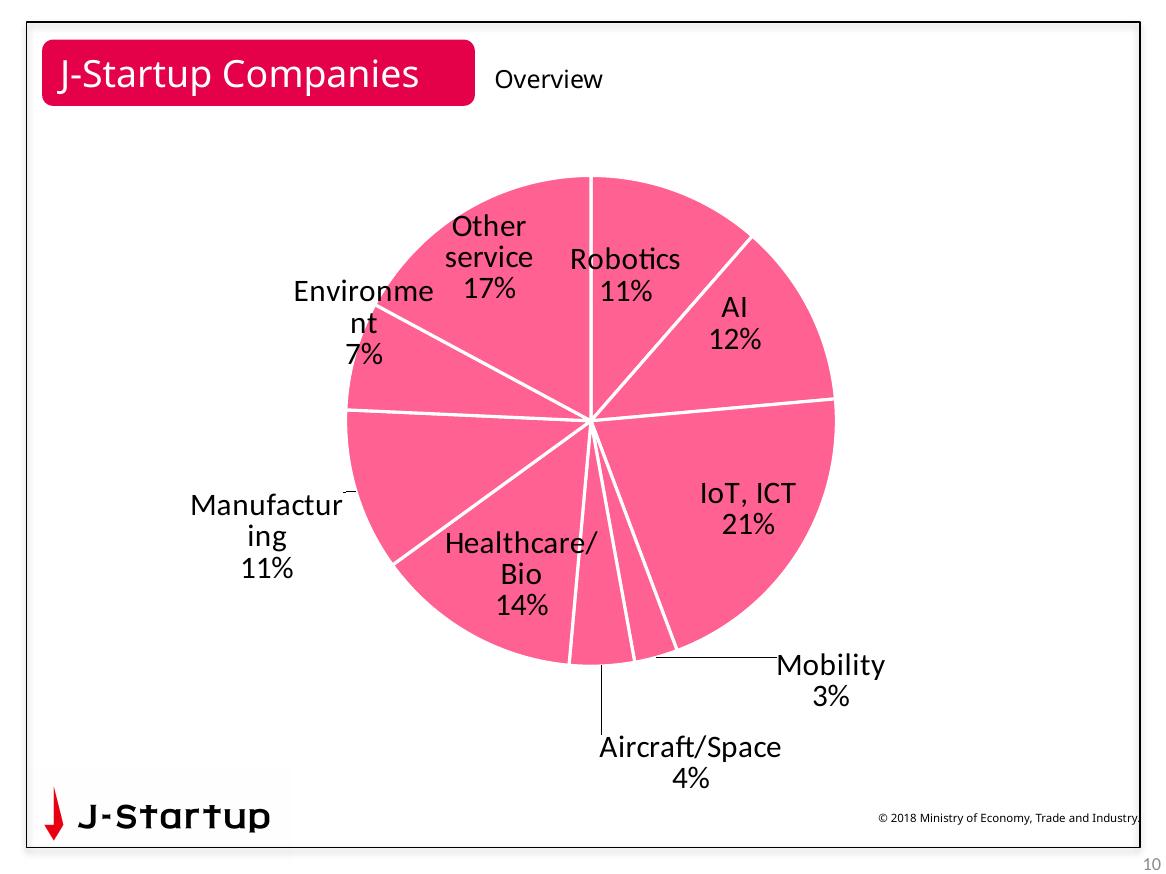
What percentage of the pie is Healthcare/Bio? 14% What is the difference in percentage points between IoT, ICT and AI? 9 What kind of chart is shown on the slide? pie chart Which category has the largest share of the pie? IoT, ICT Which category has the smallest share of the pie? Mobility What percentage is labelled for Other service? 17% Which is larger, the share for Healthcare/Bio or the share for Robotics? Healthcare/Bio Which two categories both have a share of 11%? Robotics and Manufacturing What is the combined share of Aircraft/Space and Mobility? 7% How many slices does the pie chart have? 9 What share of J-Startup companies is in IoT, ICT? 21% What is the value shown for Mobility? 3%